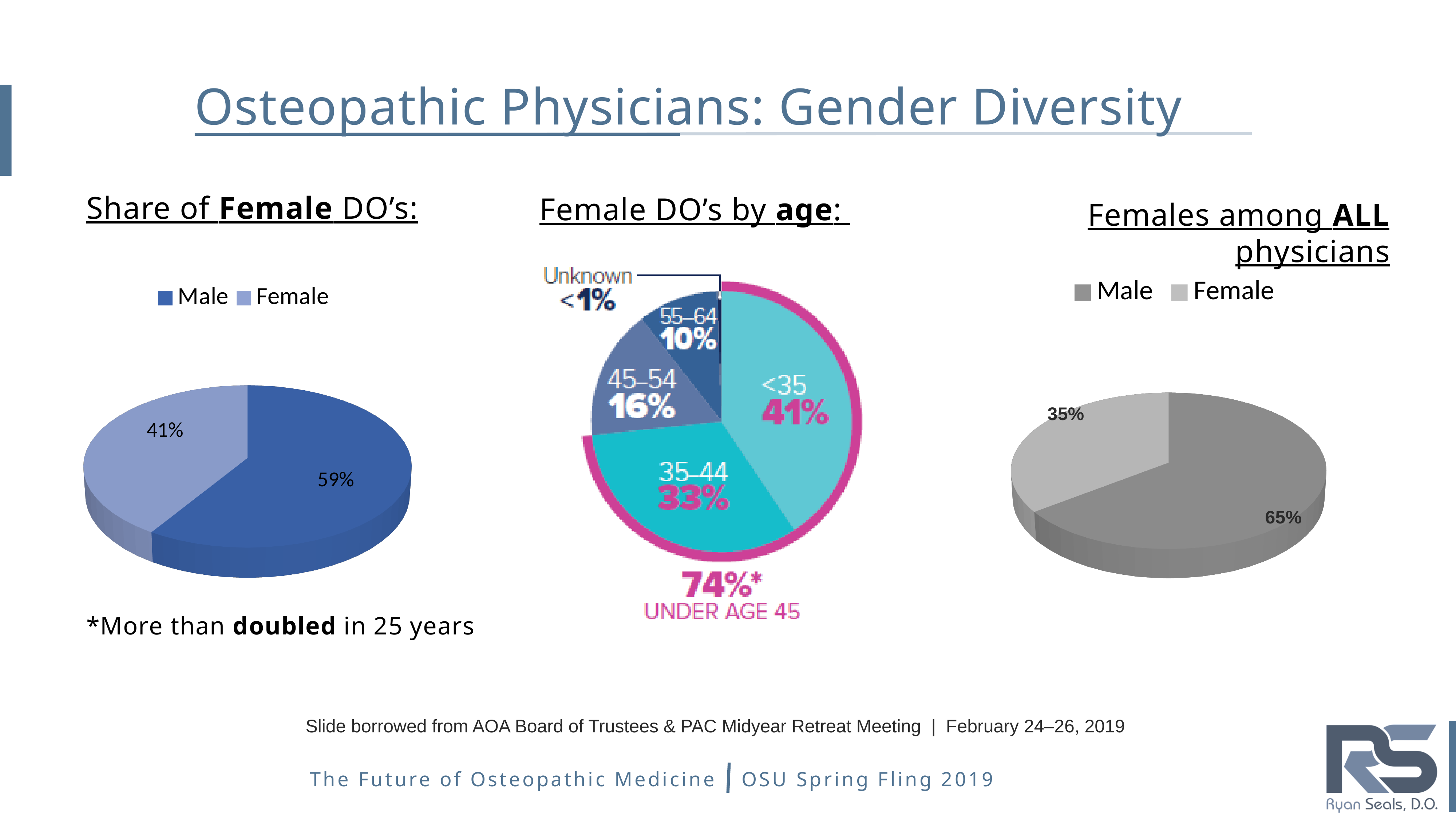
In the 'Female DO's by age' chart, which labelled age group has the smallest share? Unknown In the 'Female DO's by age' chart, what percentage of female DO's are under 35? 41% In the 'Females among ALL physicians' chart, which is larger, Male or Female? Male In the 'Females among ALL physicians' chart, what percentage is Female? 35% What kind of chart is the 'Share of Female DO's' chart? Pie chart In the 'Female DO's by age' chart, which age group has the largest share? <35 In the 'Share of Female DO's' chart, what percentage is Male? 59% In the 'Female DO's by age' chart, what percentage of female DO's are aged 45-54? 16% How many series does the legend of the 'Females among ALL physicians' chart list? 2 In the 'Share of Female DO's' chart, what is the difference between the Male and Female percentages? 18% In the 'Females among ALL physicians' chart, what percentage is Male? 65% In the 'Share of Female DO's' chart, what percentage is Female? 41%